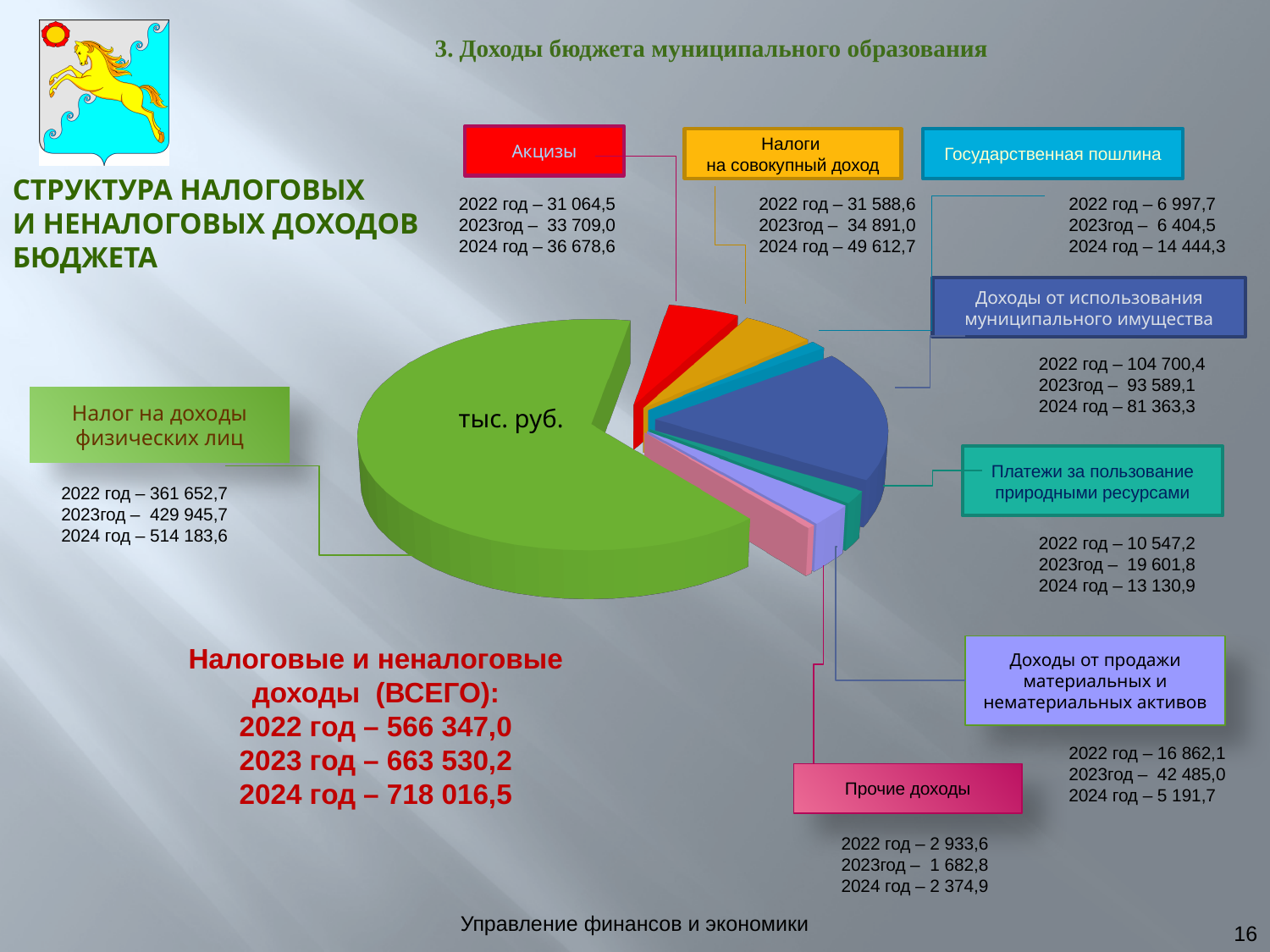
How many revenue categories (slices) does the pie chart have? 8 What kind of chart is shown on the slide? pie chart What is the total of tax and non-tax revenues (ВСЕГО) for 2024? 718 016,5 What is the value for Налог на доходы физических лиц in 2024? 514 183,6 Which is larger in 2024: Акцизы or Налоги на совокупный доход? Налоги на совокупный доход Which category has the largest value in 2024? Налог на доходы физических лиц What is the value for Прочие доходы in 2023? 1 682,8 By how much did Акцизы increase from 2022 to 2024? 5 614,1 Do the values for Доходы от использования муниципального имущества rise or fall from 2022 to 2024? fall What is the value for Акцизы in 2022? 31 064,5 Which category has the smallest value in 2024? Прочие доходы What is the value for Государственная пошлина in 2024? 14 444,3